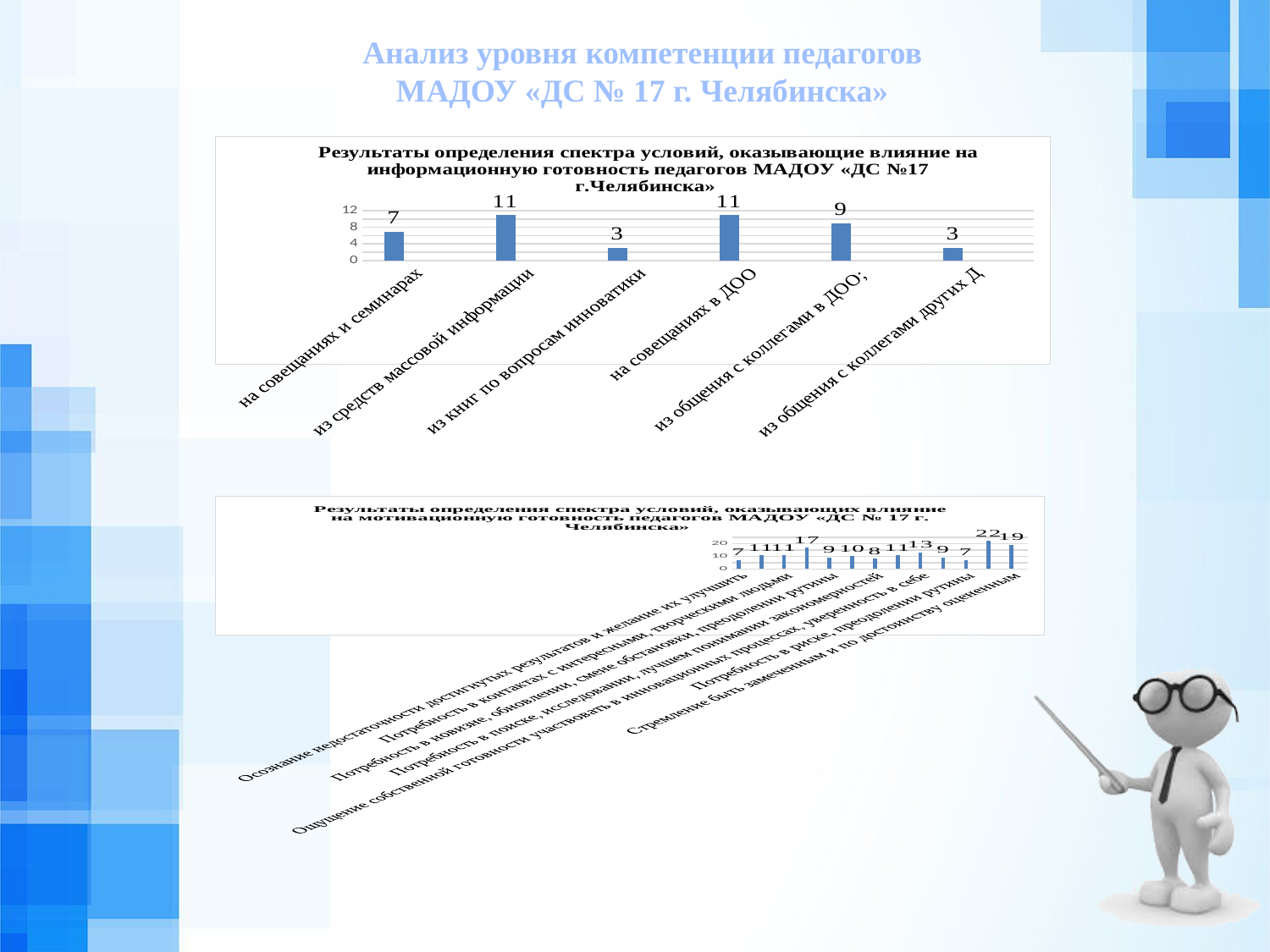
In the top chart on information readiness, what is the value for «на совещаниях и семинарах»? 7 What is the main title of the slide? Анализ уровня компетенции педагогов МАДОУ «ДС № 17 г. Челябинска» In the top chart on information readiness, which is larger: «на совещаниях и семинарах» or «из общения с коллегами в ДОО»? из общения с коллегами в ДОО In the bottom chart on motivational readiness, what is the lowest value shown on any bar? 7 In the top chart on information readiness, what is the difference between «из средств массовой информации» and «из книг по вопросам инноватики»? 8 In the top chart on information readiness, what is the value for «из средств массовой информации»? 11 In the top chart on information readiness, what is the value for «из книг по вопросам инноватики»? 3 In the bottom chart on motivational readiness, how many bars are plotted? 13 In the top chart on information readiness, how many categories are plotted? 6 In the top chart on information readiness, what is the value for «из общения с коллегами в ДОО»? 9 What type of chart is the top chart on information readiness? Bar chart In the bottom chart on motivational readiness, what is the highest value shown on any bar? 22